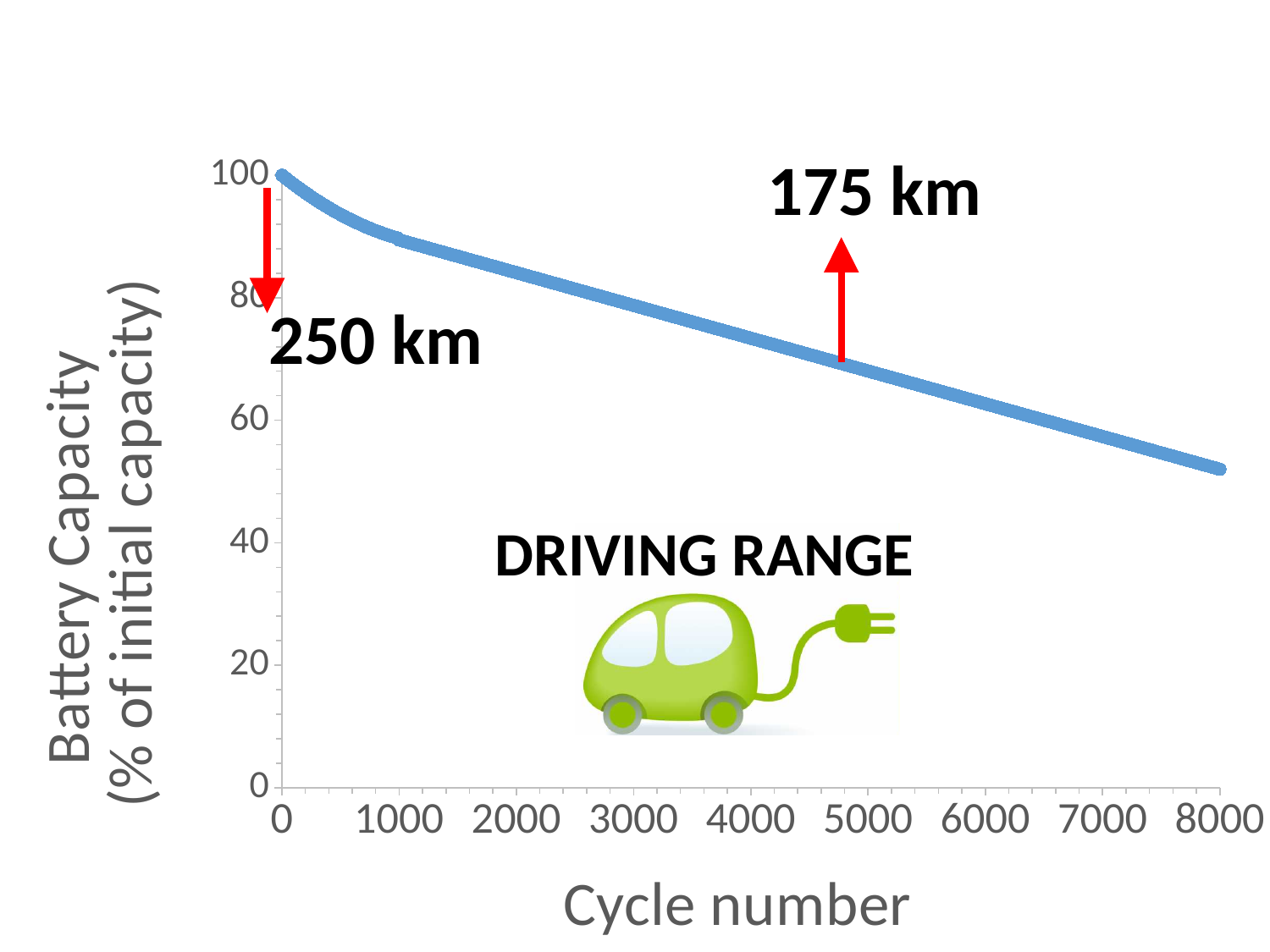
At which cycle number is the battery capacity lowest? 8000 Is the battery capacity at cycle number 2000 greater or less than 80? greater At which cycle number is the battery capacity highest? 0 What driving range is annotated at the start of the curve, and what driving range is annotated near cycle 5000? 250 km and 175 km Is the battery capacity at cycle number 4000 greater or less than 80? less Is the battery capacity at cycle number 8000 greater or less than 60? less Which is larger, the battery capacity at cycle number 1000 or at cycle number 6000? cycle number 1000 What is the label of the x axis? Cycle number Does battery capacity rise or fall as the cycle number increases? fall What kind of chart is shown on the slide? line chart What is the battery capacity (% of initial capacity) at cycle number 0? 100